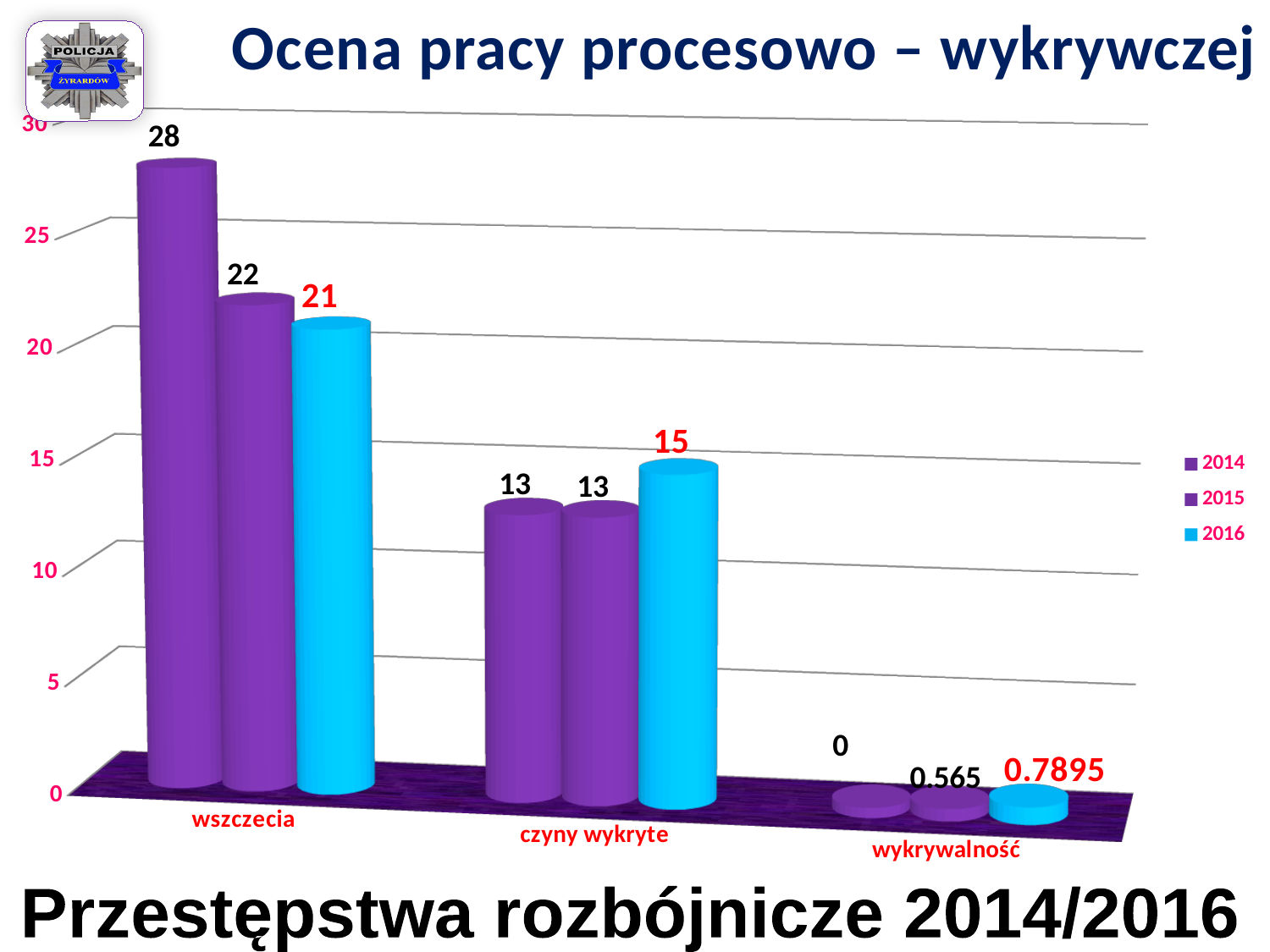
What kind of chart is shown on the slide? bar chart What is the value for 2016 in the czyny wykryte category? 15 Which year has the lowest value in the wykrywalność category? 2014 Which is larger in the czyny wykryte category, the 2015 value or the 2016 value? 2016 How many series does the legend list? 3 What is the difference between the 2014 and 2016 values in the wszczecia category? 7 What is the value for 2015 in the wykrywalność category? 0.565 What is the value for 2016 in the wykrywalność category? 0.7895 Which year has the highest value in the wszczecia category? 2014 What is the value for 2014 in the wszczecia category? 28 How many categories are shown on the x axis? 3